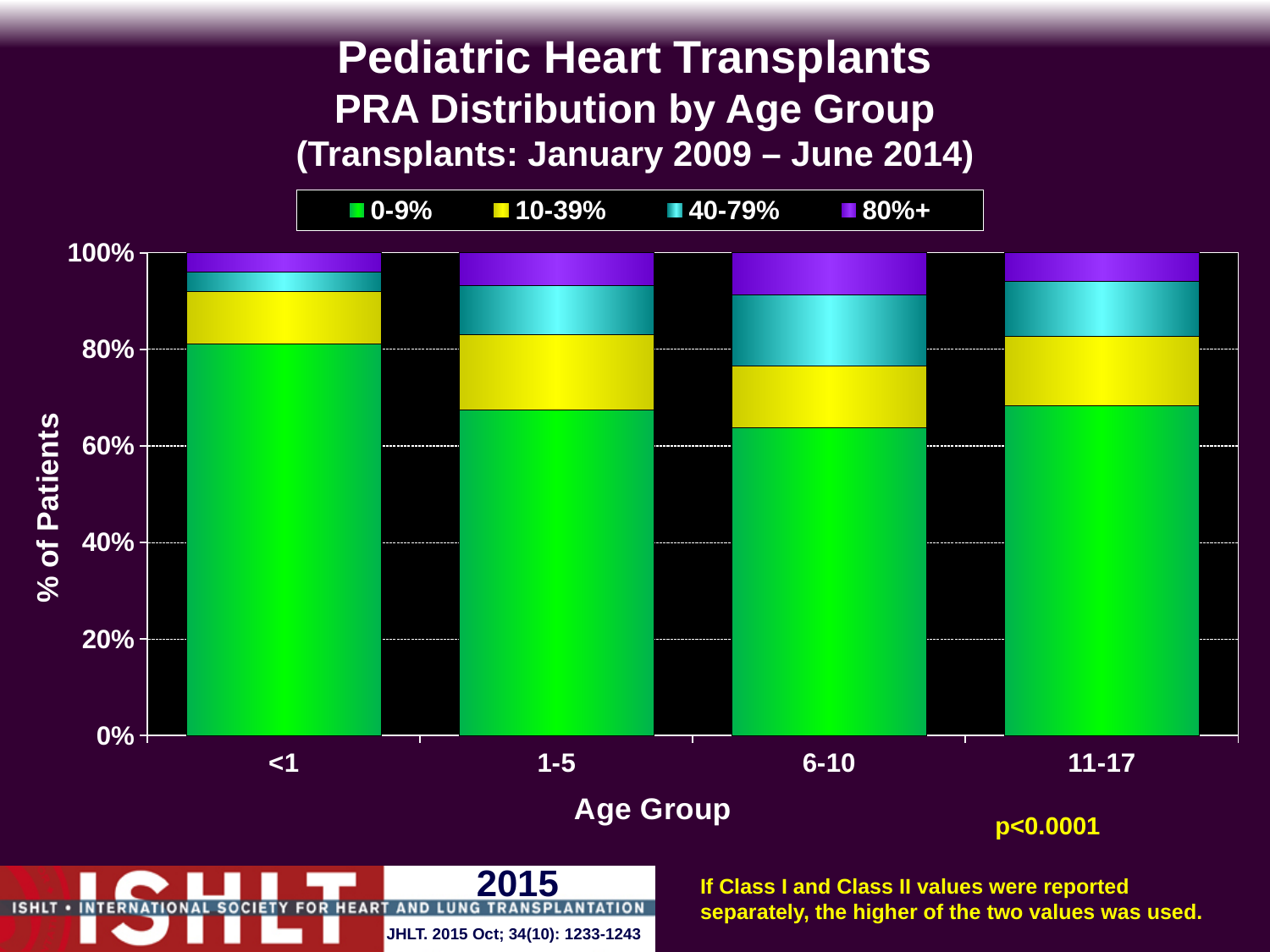
What is the label of the x axis? Age Group What is the total of the stacked bar for the 11-17 age group? 100% What kind of chart is shown on the slide? Stacked bar chart Is the 0-9% value for the 6-10 age group greater or less than 80%? less Which age group has the largest 0-9% segment? <1 What is the label of the y axis? % of Patients Which age group has the smallest 0-9% segment? 6-10 How many series does the legend list? 4 How many age groups are shown on the x axis? 4 Is the 0-9% value for the 1-5 age group greater or less than 60%? greater Which age group has the largest 40-79% segment, <1 or 6-10? 6-10 Is the 0-9% value for the <1 age group greater or less than 60%? greater